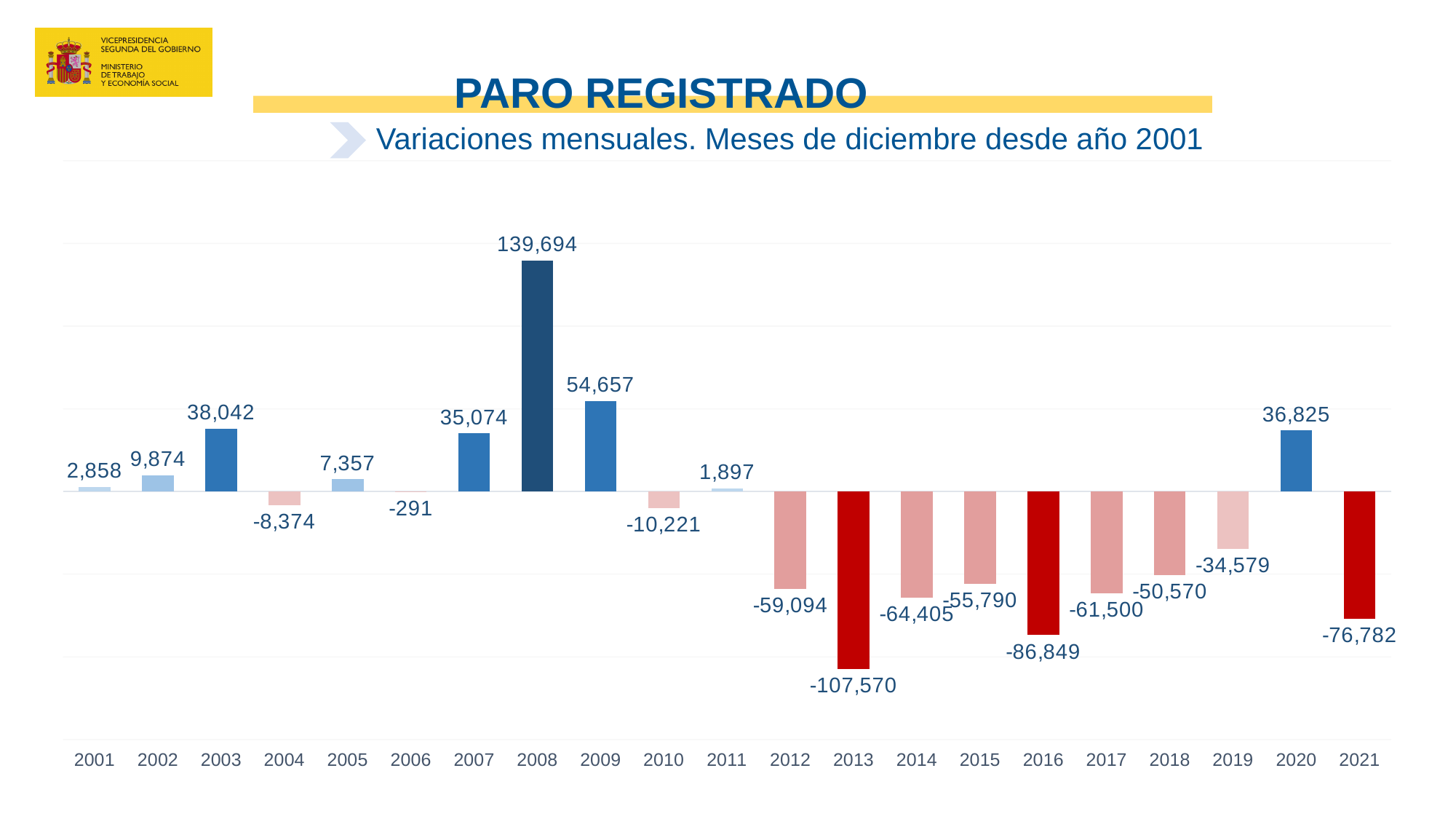
Which year has the highest value? 2008 What is the difference between the values for 2008 and 2009? 85,037 Which year has the larger value, 2007 or 2009? 2009 What is the value for 2008? 139,694 What is the value for 2021? -76,782 What kind of chart is shown on the slide? Bar chart How many years are shown on the x axis? 21 Which year has the lowest value? 2013 What is the value for 2006? -291 What is the title of the chart? PARO REGISTRADO What is the difference between the values for 2003 and 2020? 1,217 What is the value for 2013? -107,570